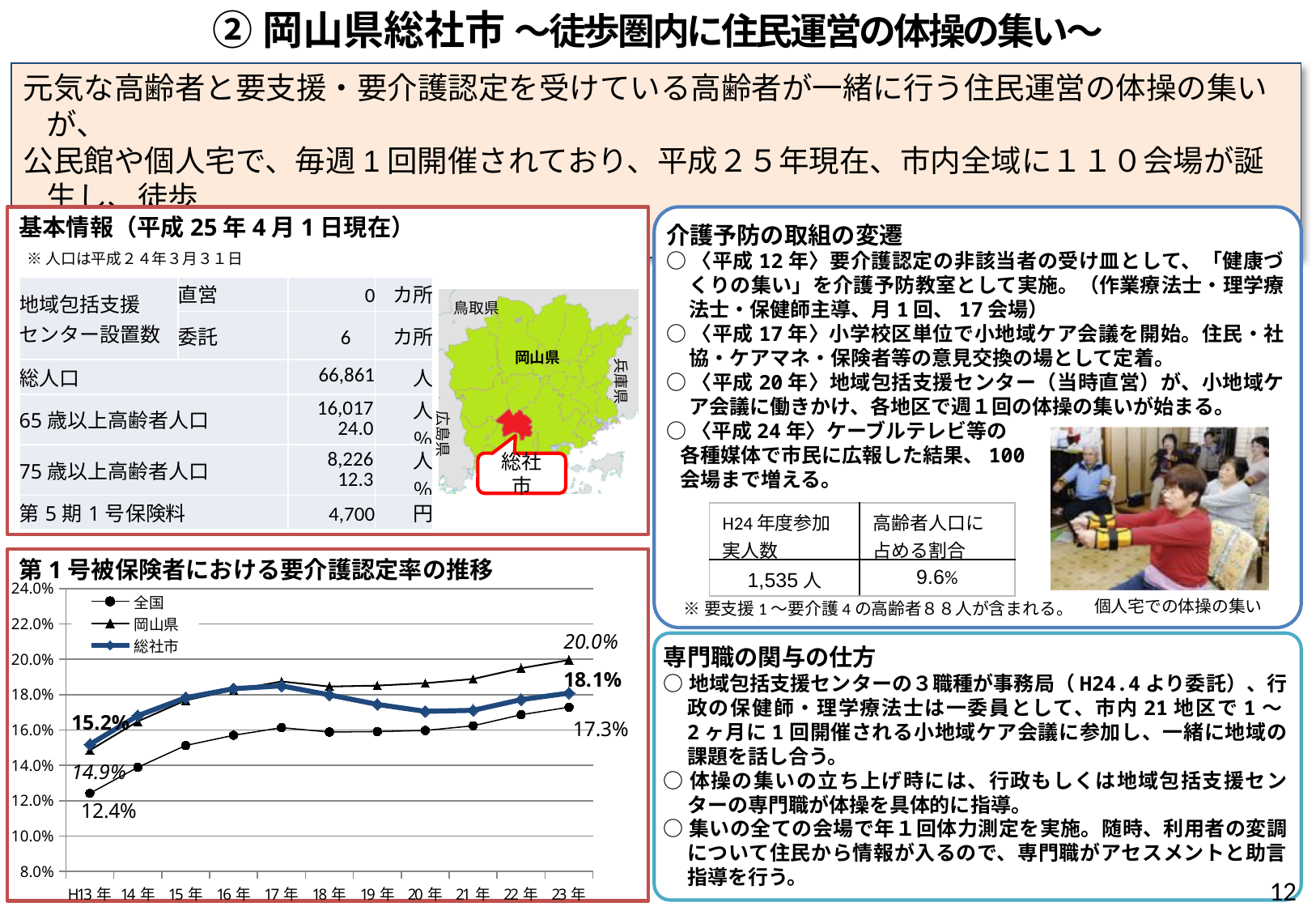
In the 要介護認定率の推移 chart, what is the value for 総社市 in H13年? 15.2% What kind of chart is 「第1号被保険者における要介護認定率の推移」? line chart In the 要介護認定率の推移 chart, what is the value for 全国 in H13年? 12.4% How many years are shown on the x axis of the 要介護認定率の推移 chart? 11 In the 要介護認定率の推移 chart, which series has the highest value in 23年? 岡山県 In the 要介護認定率の推移 chart, what is the value for 岡山県 in 23年? 20.0% How many series does the legend of the 要介護認定率の推移 chart list? 3 In the 要介護認定率の推移 chart, does the 全国 line rise or fall from H13年 to 23年? rise In the 要介護認定率の推移 chart, what is the difference between 岡山県 and 総社市 in 23年? 1.9 percentage points In the 要介護認定率の推移 chart, which series has the lowest value in H13年? 全国 In the 要介護認定率の推移 chart, is the value for 全国 in 15年 greater or less than 16.0%? less In the 要介護認定率の推移 chart, what is the value for 総社市 in 23年? 18.1%